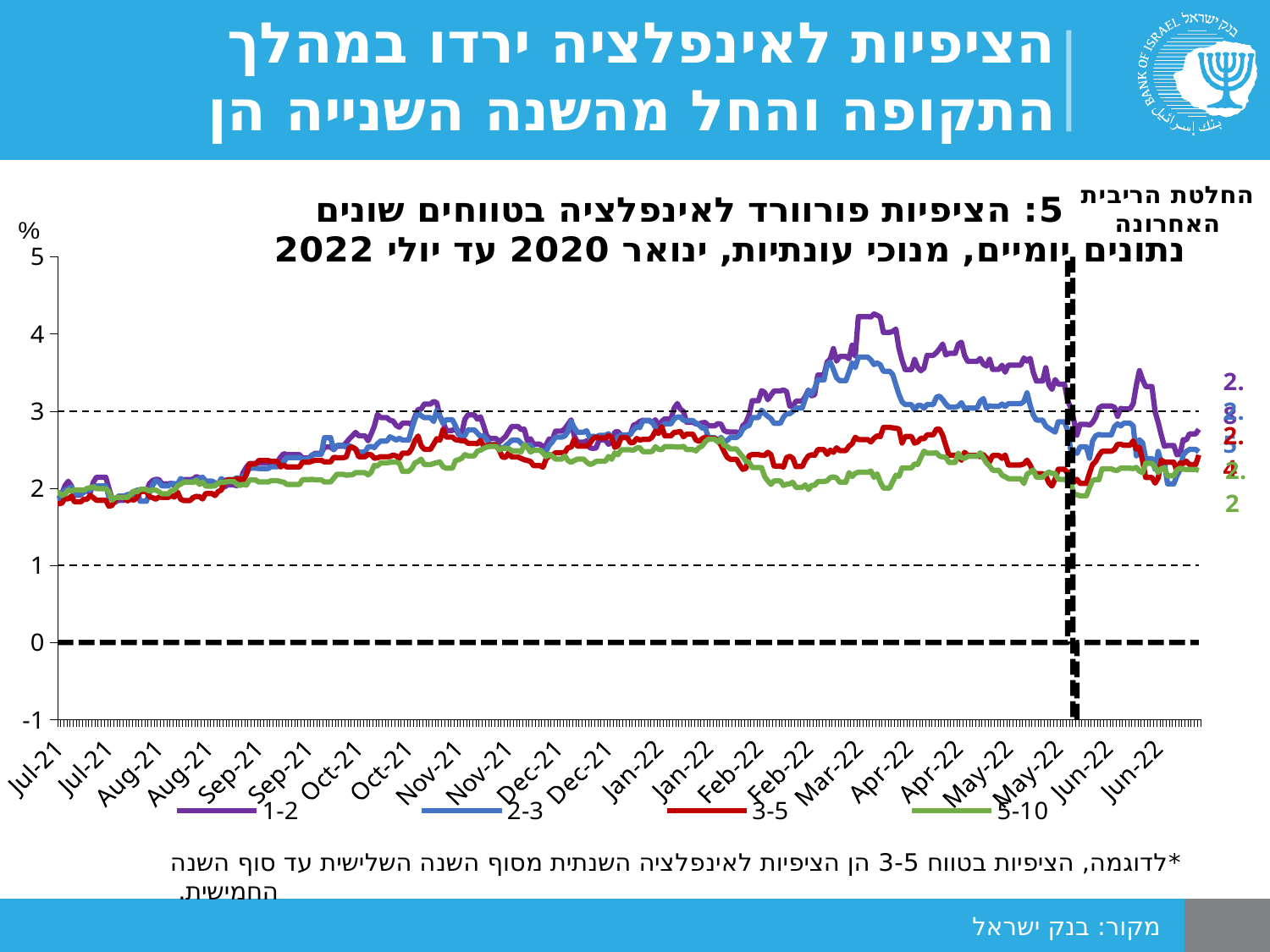
What unit is shown on the y axis? % Does the 1-2 series rise or fall from Apr-22 to Jun-22? fall Does the 1-2 series rise or fall from Jul-21 to Apr-22? rise How many series does the legend list? 4 Around Apr-22, which series is higher, 1-2 or 5-10? 1-2 Which series is the lowest around Mar-22? 5-10 Which series reaches the highest value anywhere on the chart? 1-2 What are the four series names listed in the legend? 1-2, 2-3, 3-5, 5-10 Is the peak value of the 1-2 series greater or less than 3? greater Is the highest value of the 5-10 series greater or less than 3? less What kind of chart is shown on the slide? line chart Is the value of the 5-10 series at Jul-21 greater or less than 3? less